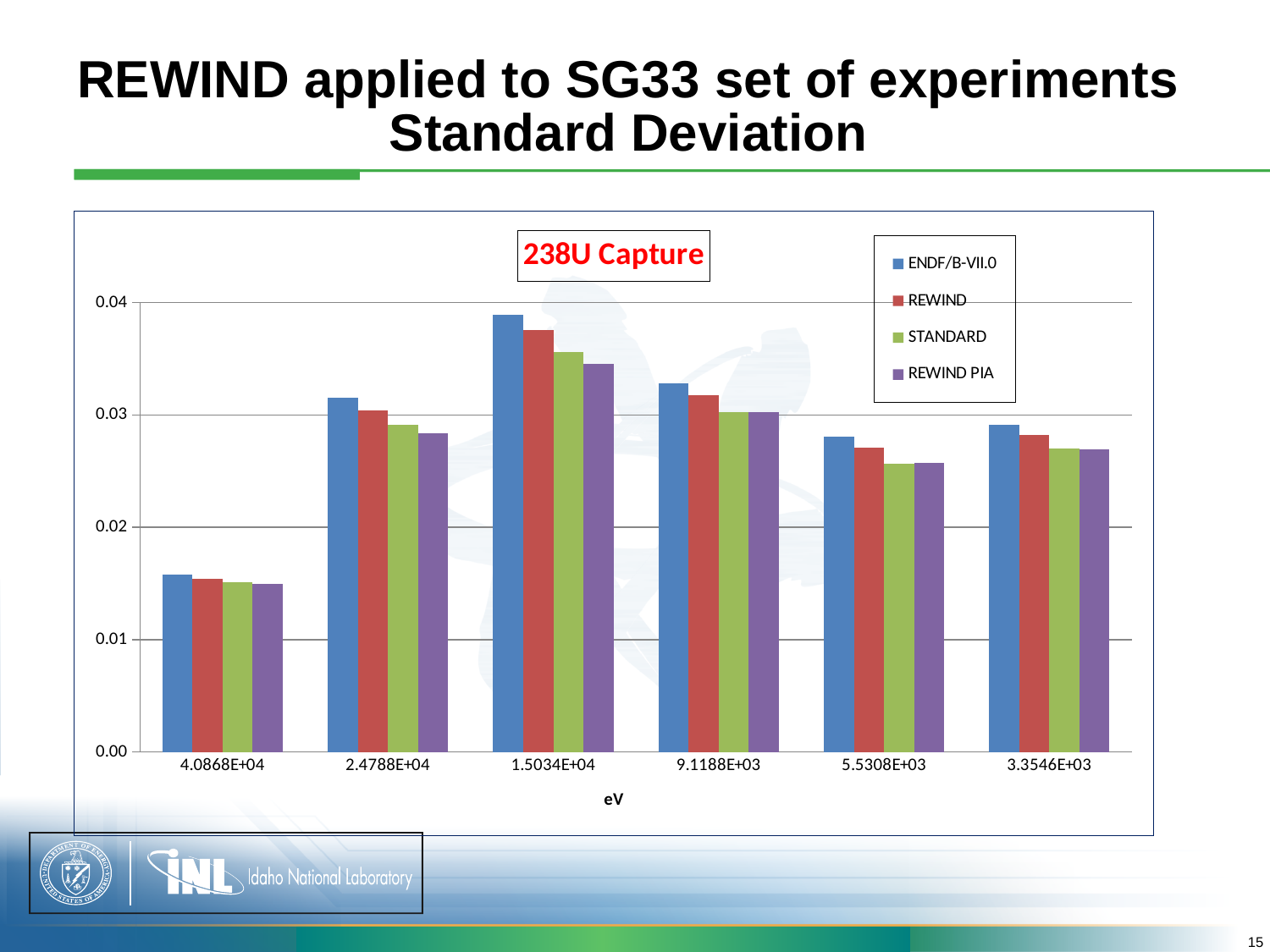
At which energy category is the REWIND standard deviation lowest? 4.0868E+04 How many series does the legend list? 4 What kind of chart is shown on the slide? bar chart Is the ENDF/B-VII.0 value at 9.1188E+03 greater or less than 0.03? greater At which energy category is the ENDF/B-VII.0 standard deviation highest? 1.5034E+04 Is the STANDARD value at 5.5308E+03 greater or less than 0.03? less Is the ENDF/B-VII.0 value at 4.0868E+04 greater or less than 0.02? less What label is shown in the red box above the chart? 238U Capture How many energy categories are shown on the x axis? 6 At 2.4788E+04, which is larger: the ENDF/B-VII.0 value or the REWIND PIA value? ENDF/B-VII.0 Do the ENDF/B-VII.0 values rise or fall from 4.0868E+04 to 1.5034E+04? rise